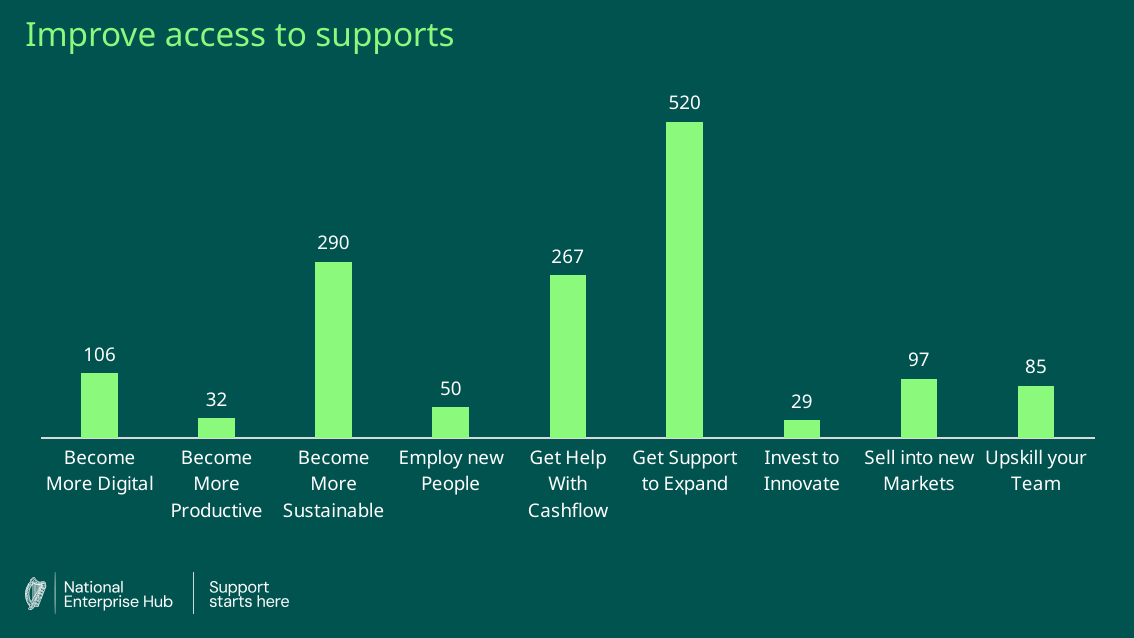
How many categories are shown in the chart? 9 Which category has the highest value? Get Support to Expand What is the value for Get Support to Expand? 520 Which is larger, the value for Employ new People or the value for Upskill your Team? Upskill your Team What kind of chart is shown on the slide? Bar chart What is the value for Invest to Innovate? 29 What is the difference between the values for Become More Digital and Sell into new Markets? 9 What is the title of the chart? Improve access to supports Which is larger, the value for Become More Sustainable or the value for Get Help With Cashflow? Become More Sustainable What is the difference between the values for Get Support to Expand and Get Help With Cashflow? 253 What is the value for Become More Sustainable? 290 Which category has the lowest value? Invest to Innovate